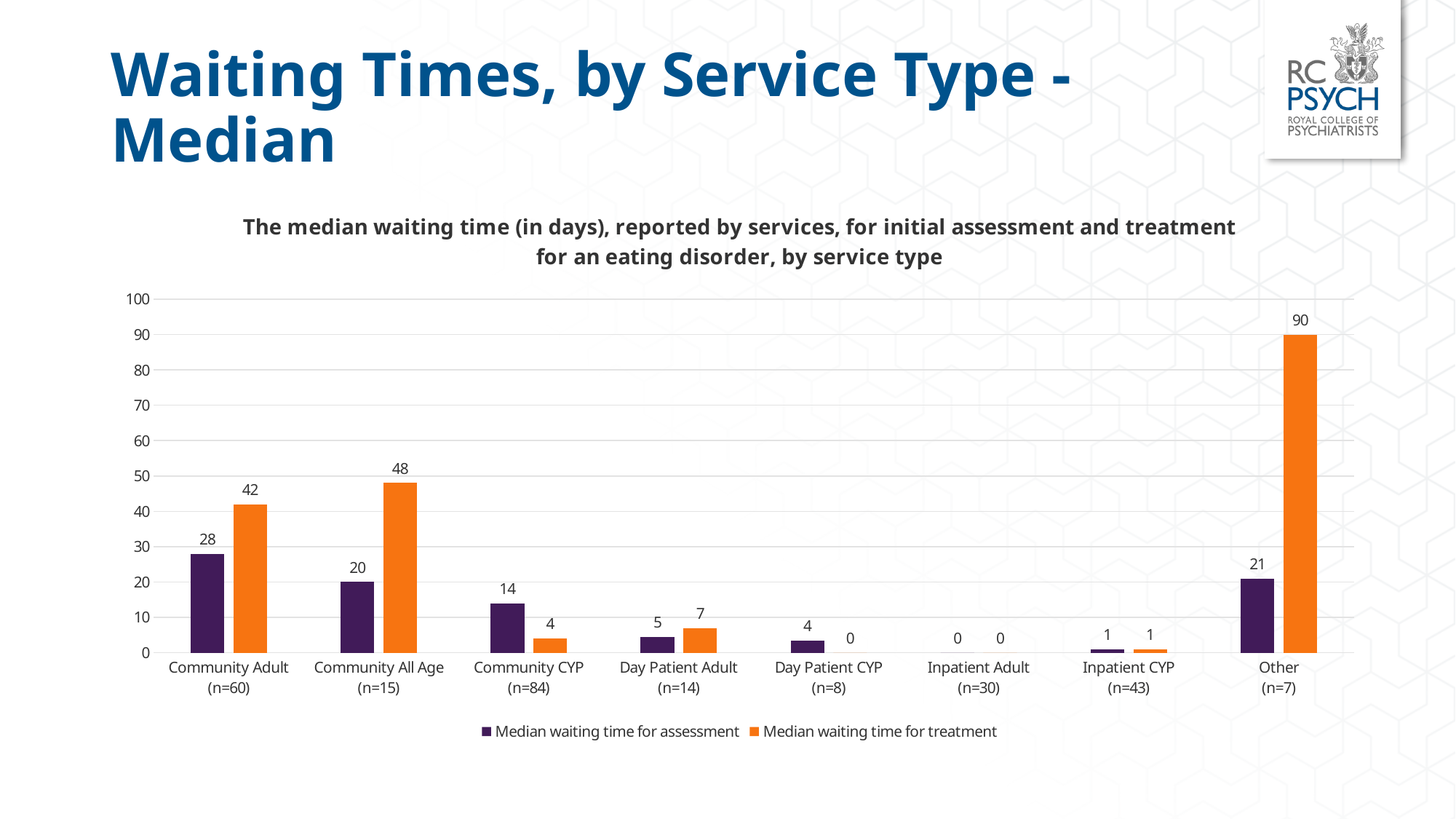
Which is larger for Community CYP (n=84): the median waiting time for assessment or for treatment? Median waiting time for assessment How many series does the legend list? 2 What is the median waiting time for treatment for Community Adult (n=60)? 42 Which service type has the lowest median waiting time for assessment? Inpatient Adult (n=30) What kind of chart is shown on the slide? Bar chart What is the median waiting time for assessment for Community CYP (n=84)? 14 What is the difference between the median waiting time for treatment and for assessment for Community All Age (n=15)? 28 Which service type has the highest median waiting time for treatment? Other (n=7) How many service types are shown on the x axis? 8 What is the median waiting time for treatment for Other (n=7)? 90 Which service type has the highest median waiting time for assessment? Community Adult (n=60) Is the median waiting time for treatment for Other (n=7) greater or less than 80? greater